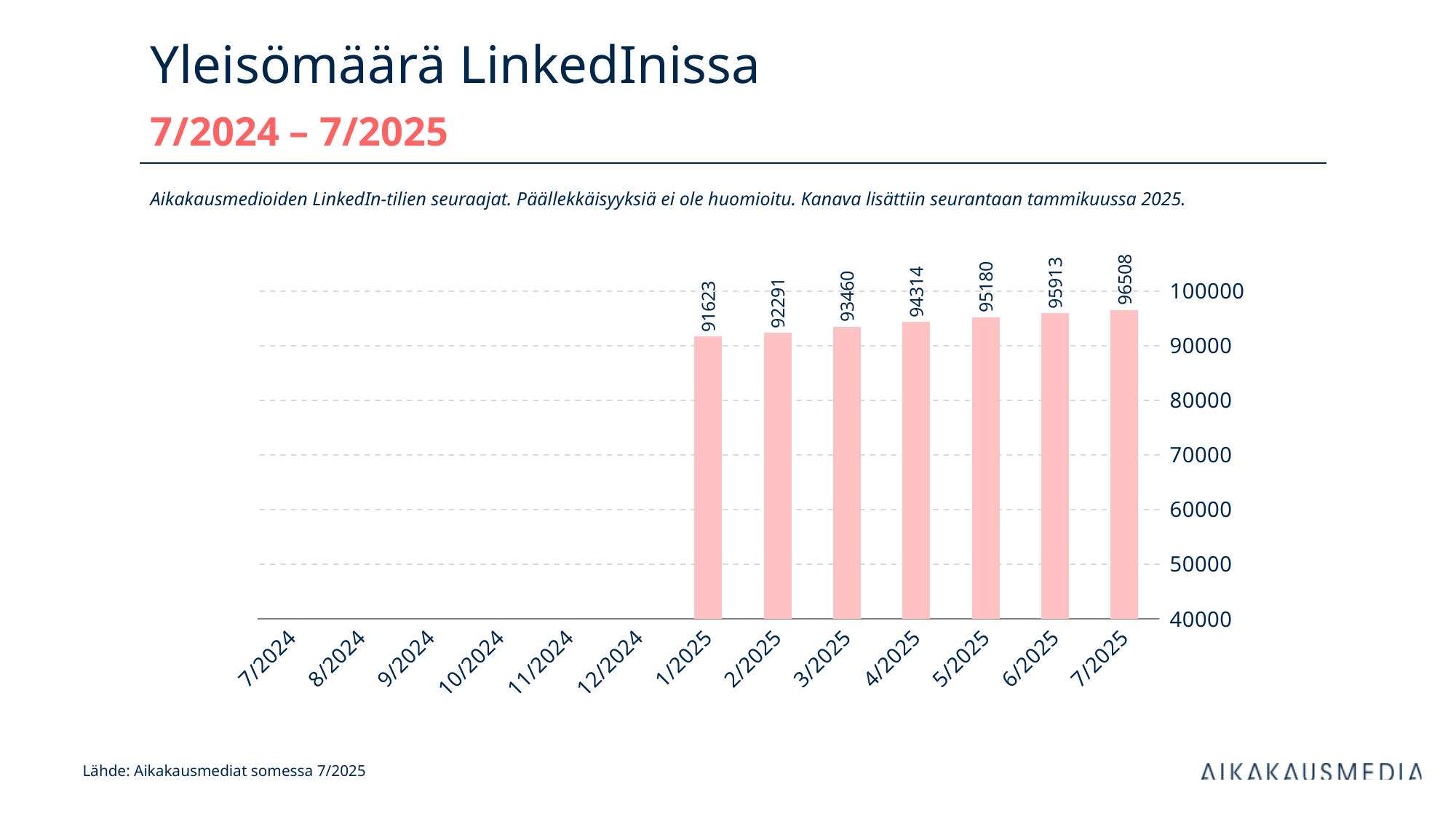
What is the value for 7/2025? 96508 What is the difference between the values for 3/2025 and 2/2025? 1169 Among the months with a plotted bar, which has the lowest value? 1/2025 What kind of chart is shown? bar chart What is the value for 4/2025? 94314 Which is larger, the value for 5/2025 or the value for 6/2025? 6/2025 What is the difference between the values for 7/2025 and 1/2025? 4885 Do the values rise or fall from 1/2025 to 7/2025? rise Which month has the highest value? 7/2025 How many months have a plotted bar? 7 Is the value for 2/2025 greater or less than 90000? greater What is the value for 1/2025? 91623